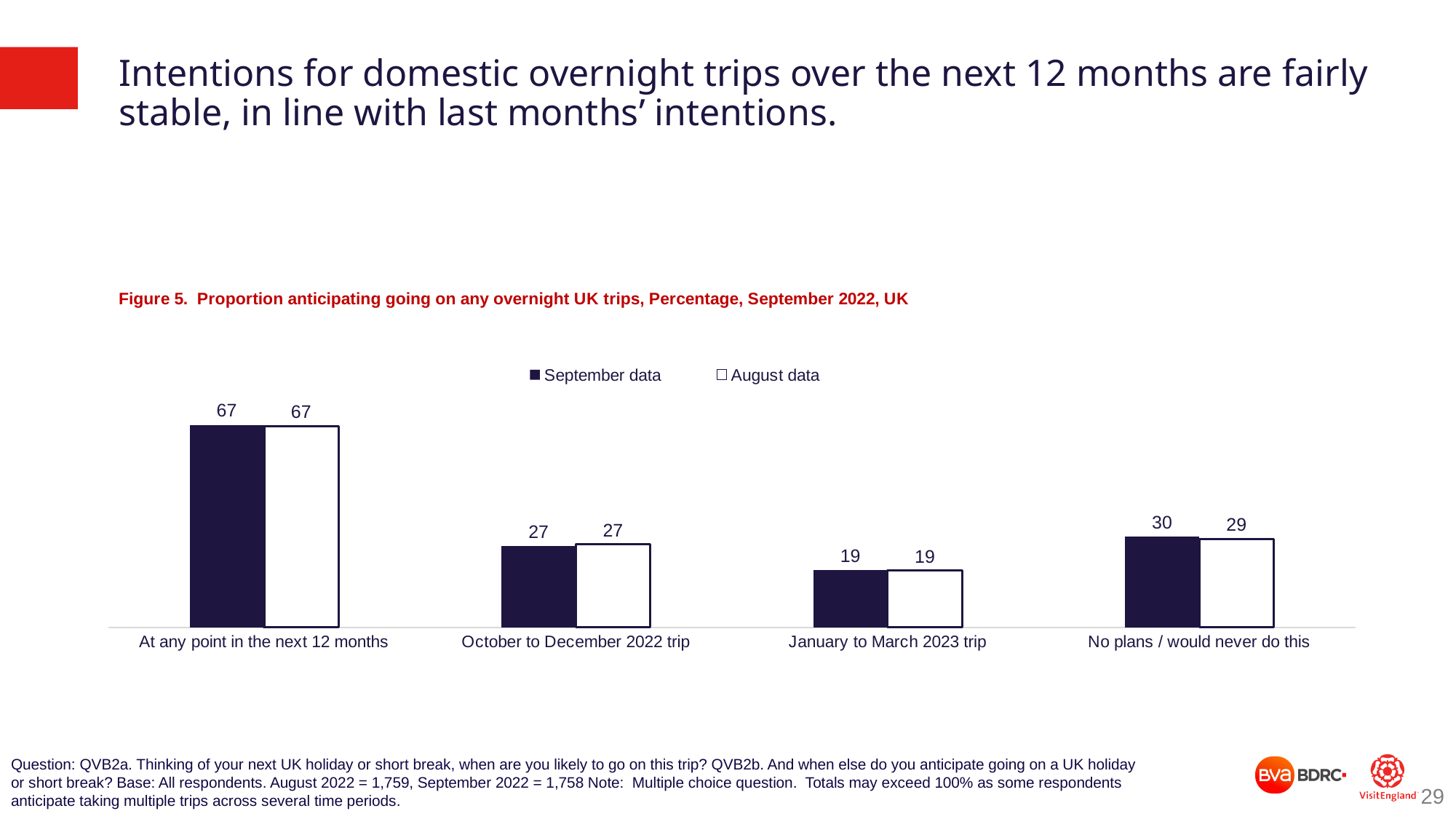
What is the September data value for 'January to March 2023 trip'? 19 Which category has the lowest August data value? January to March 2023 trip What is the difference between the September data values for 'At any point in the next 12 months' and 'October to December 2022 trip'? 40 Which category has the highest September data value? At any point in the next 12 months What is the difference between the September and August data values for 'No plans / would never do this'? 1 How many series does the legend list? 2 What is the September data value for 'At any point in the next 12 months'? 67 What kind of chart is shown on the slide? Bar chart What is the August data value for 'No plans / would never do this'? 29 How many categories are shown on the x axis? 4 What are the two series named in the legend? September data and August data Which is larger: the September data value for 'October to December 2022 trip' or for 'No plans / would never do this'? No plans / would never do this